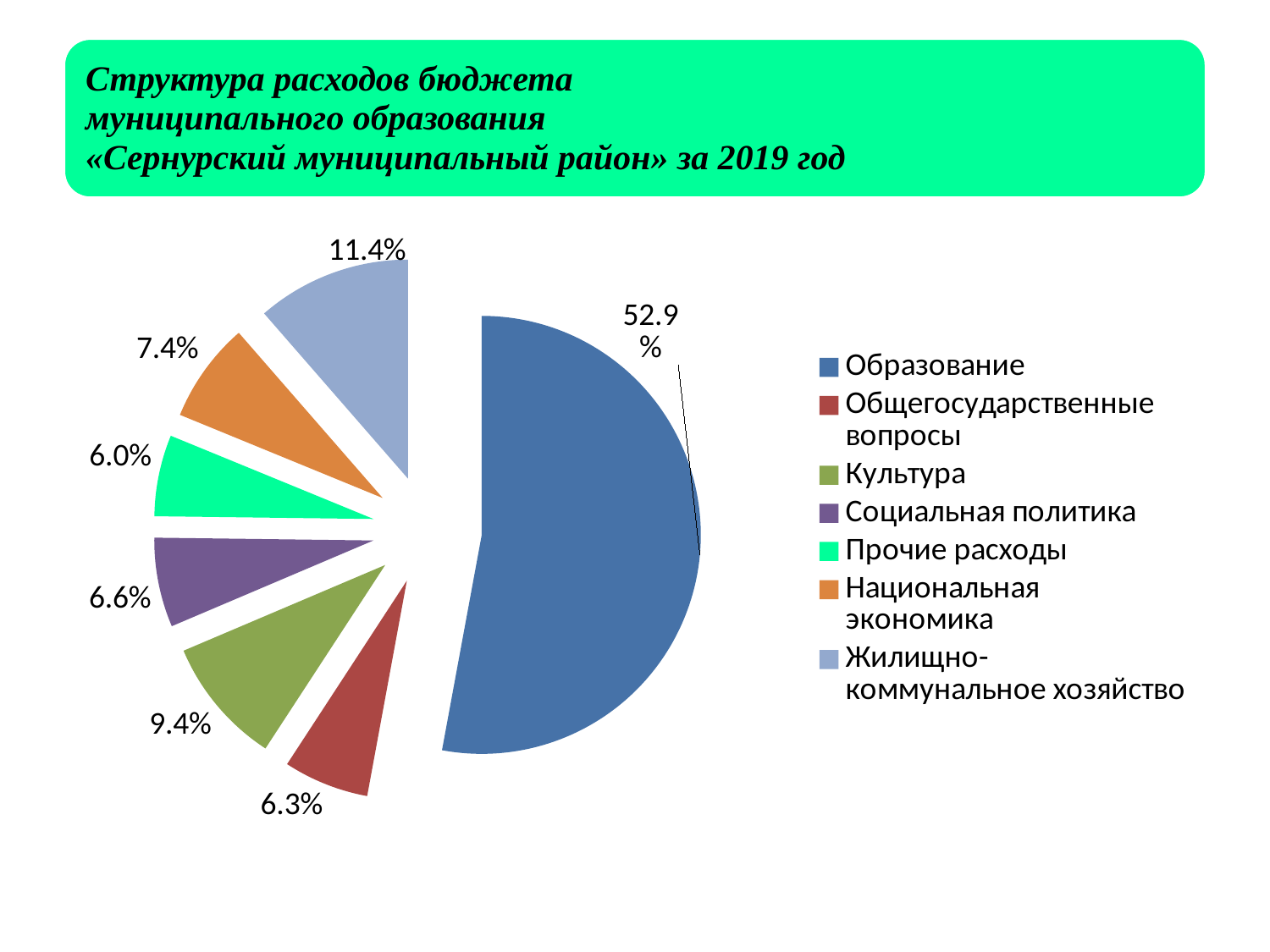
What share of budget expenditure is labelled for Образование? 52.9% Which category has the smallest share of the pie? Прочие расходы What percentage is shown for Общегосударственные вопросы? 6.3% Which is larger, the share for Культура or the share for Национальная экономика? Культура What type of chart is shown on the slide? Pie chart What percentage is shown for Жилищно-коммунальное хозяйство? 11.4% Which category has the largest share of the pie? Образование What percentage is shown for Социальная политика? 6.6% What is the difference in percentage points between Образование and Жилищно-коммунальное хозяйство? 41.5 What percentage is shown for Культура? 9.4% What percentage is shown for Национальная экономика? 7.4% How many categories does the legend list? 7